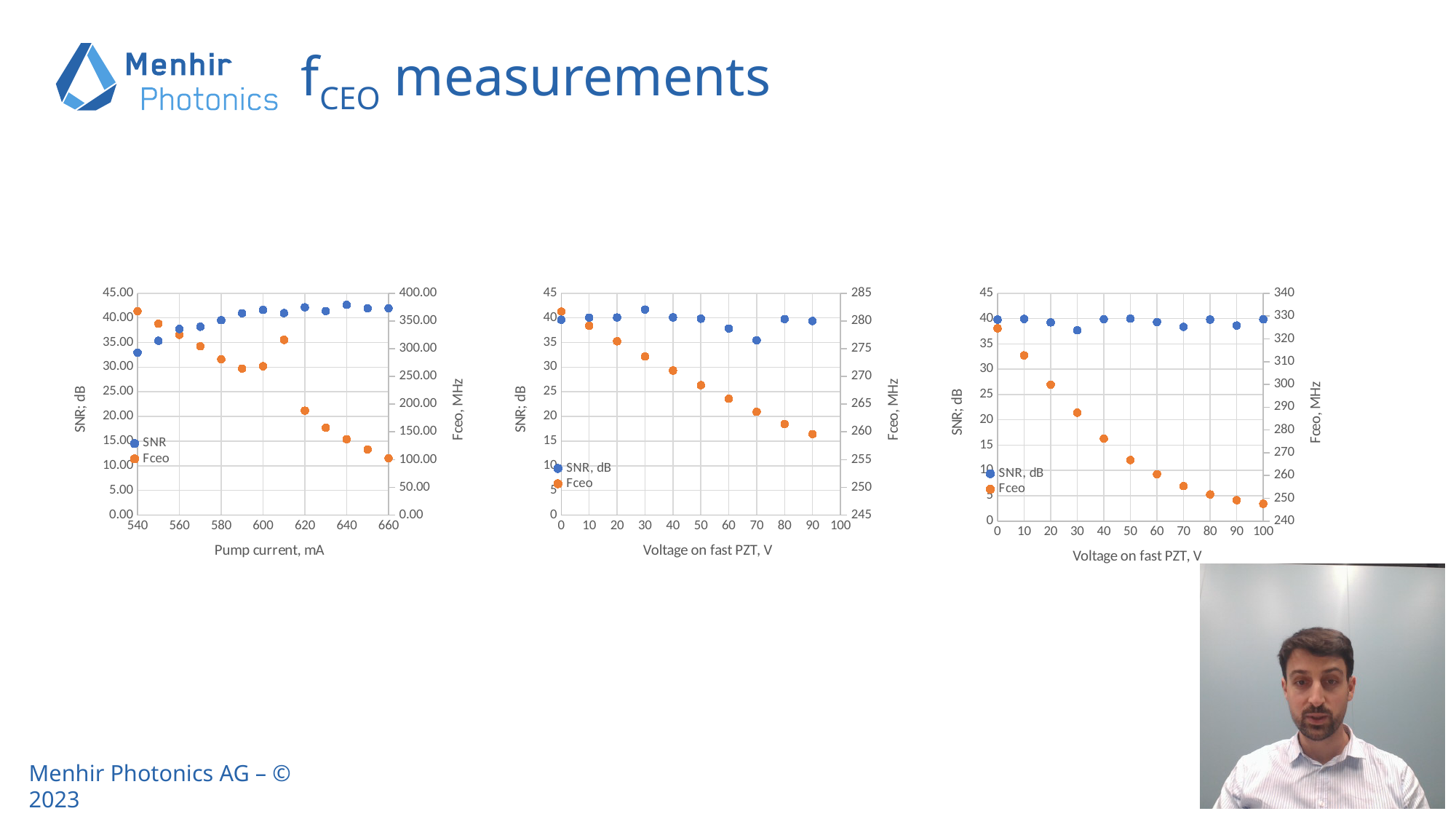
In the middle chart (Voltage on fast PZT, V), does the Fceo series rise or fall as voltage increases? fall How many series does the legend of the left chart (Pump current, mA) list? 2 What kind of chart is the left chart with x axis 'Pump current, mA'? scatter chart In the right chart (Voltage on fast PZT, V, with right axis up to 340), is the Fceo value at 100 V greater or less than 260 MHz? less In the left chart (Pump current, mA), is the SNR value at 540 mA greater or less than 40.00 dB? less In the left chart (Pump current, mA), is the Fceo value at 660 mA greater or less than 150.00 MHz? less In the right chart (Voltage on fast PZT, V, with right axis up to 340), how many data points does the Fceo series have? 11 In the middle chart (Voltage on fast PZT, V), how many data points does the Fceo series have? 10 In the left chart (Pump current, mA), does the Fceo series rise or fall overall as pump current increases from 540 to 660 mA? fall What is the label of the right-hand vertical axis on the middle chart? Fceo, MHz In the left chart (Pump current, mA), how many data points does the Fceo series have? 13